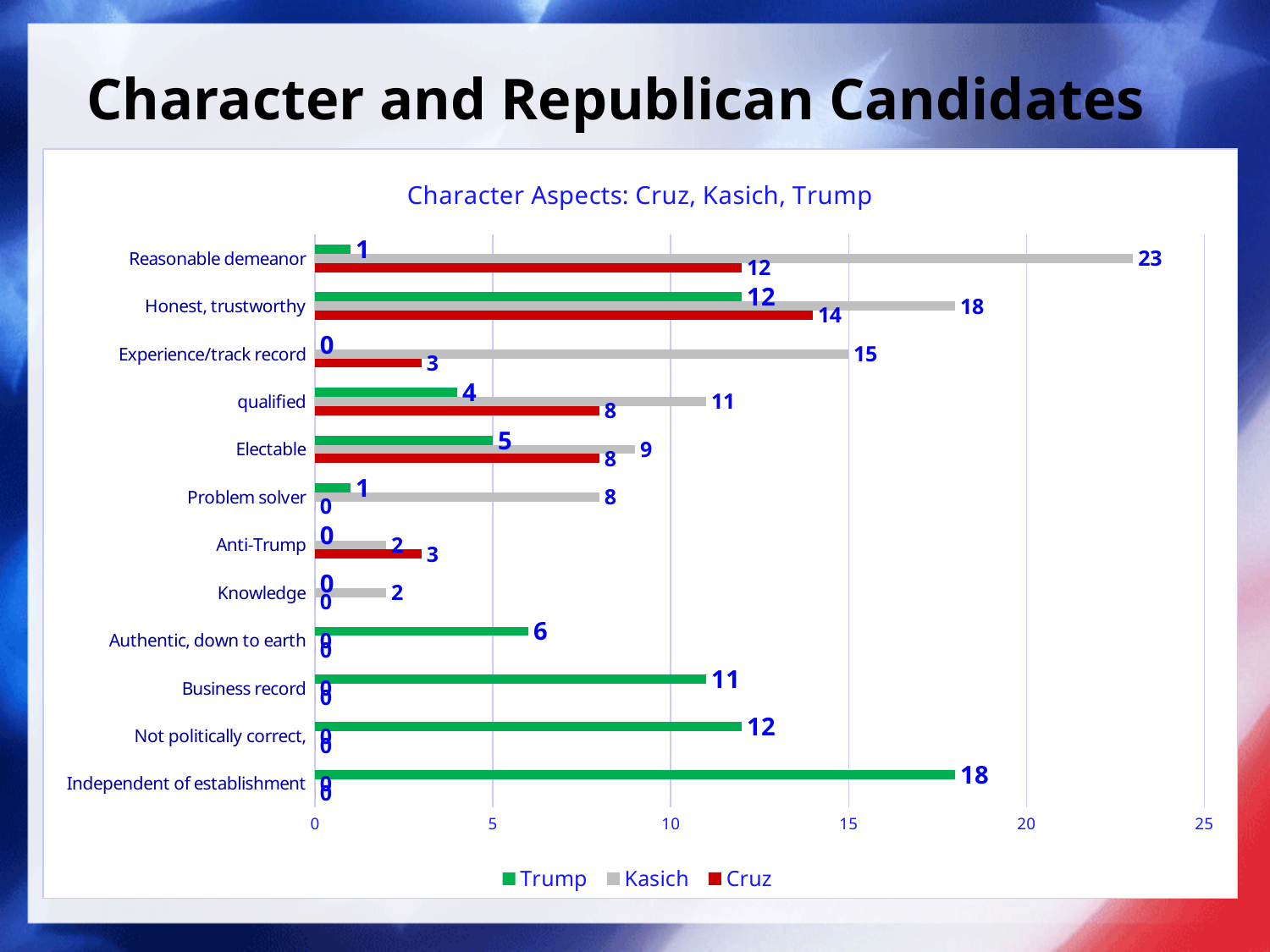
What is the Kasich value for Reasonable demeanor? 23 What kind of chart is this? Bar chart What is the Cruz value for Honest, trustworthy? 14 What is the Trump value for Independent of establishment? 18 Which category has the highest Trump value? Independent of establishment Which category has the highest Kasich value? Reasonable demeanor For Honest, trustworthy, which is larger: the Kasich value or the Trump value? Kasich Which colour represents Cruz in the legend? Red What is the difference between the Kasich and Cruz values for Reasonable demeanor? 11 How many categories are shown on the y axis? 12 What is the title of the chart? Character Aspects: Cruz, Kasich, Trump How many series does the legend list? 3